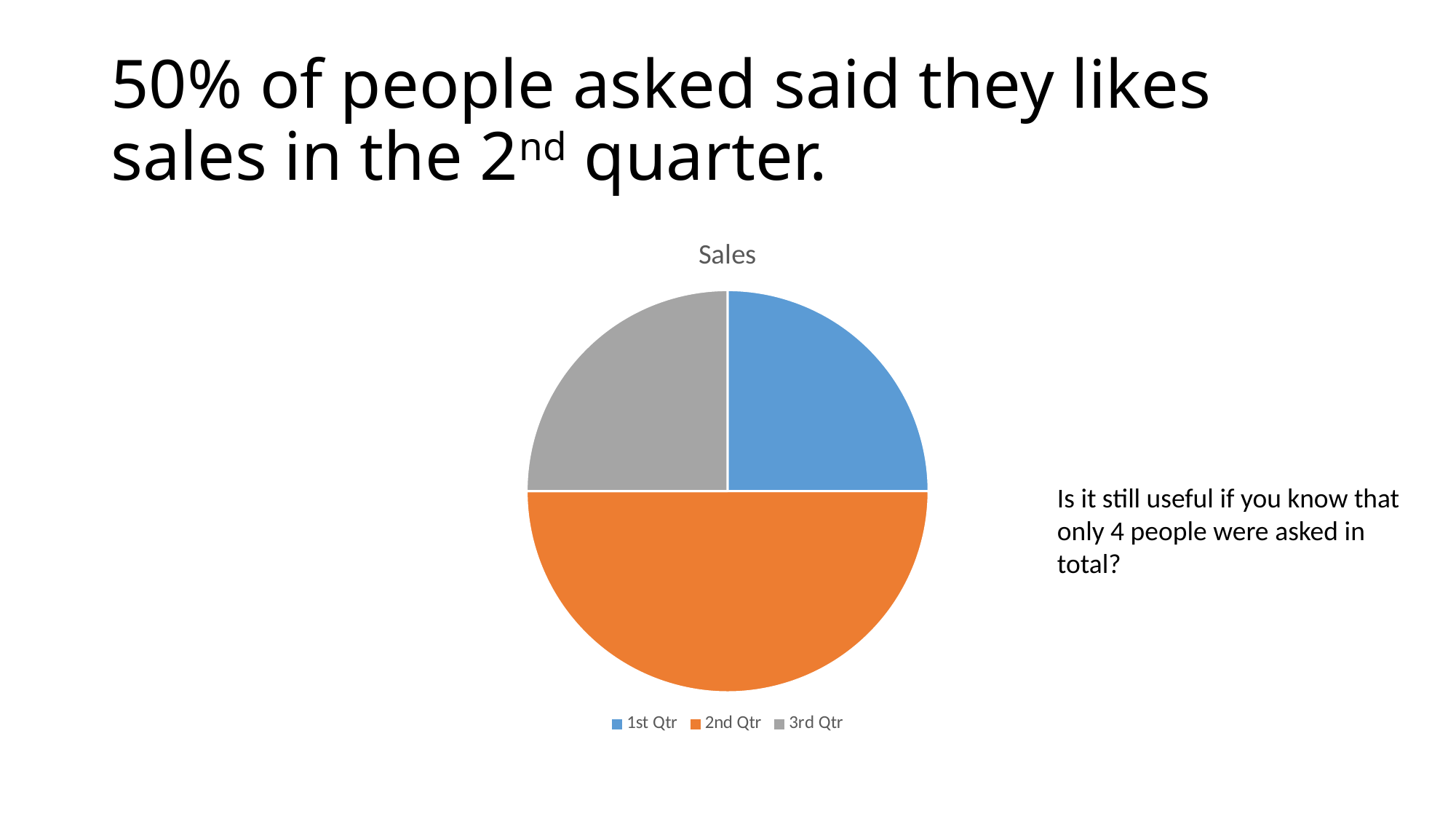
What colour is the 2nd Qtr slice? orange What are the legend entries of the chart, in order? 1st Qtr, 2nd Qtr, 3rd Qtr What is the title of the chart? Sales What share of the pie does the 2nd Qtr slice represent? 50% Which slice is larger, 3rd Qtr or 2nd Qtr? 2nd Qtr How many entries does the legend list? 3 How many slices does the pie chart have? 3 Which slice is larger, 1st Qtr or 2nd Qtr? 2nd Qtr What kind of chart is shown on the slide? pie chart Which category has the largest slice of the pie? 2nd Qtr